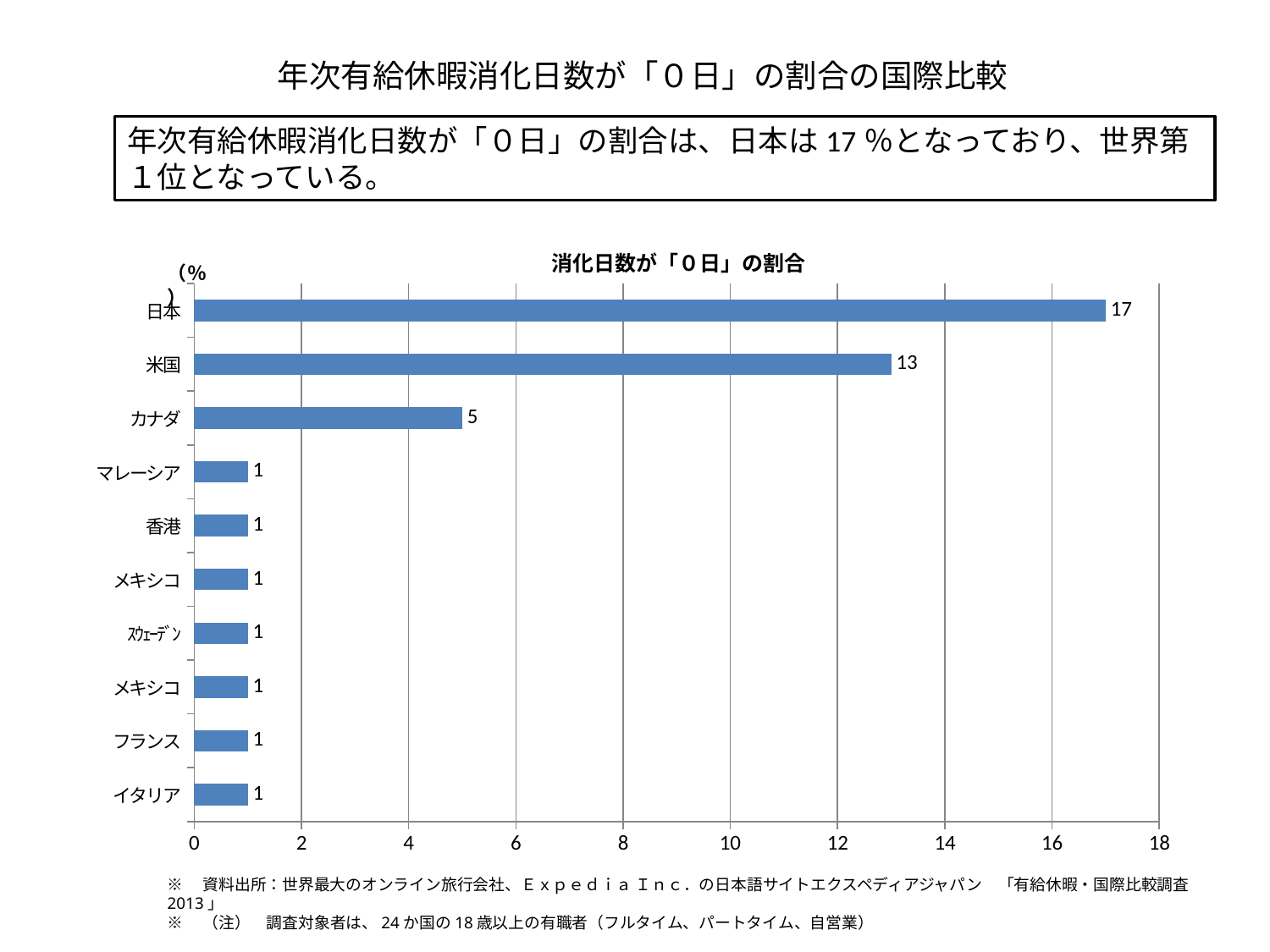
What is the difference between the values for 米国 and カナダ? 8 How many bars (categories) are shown in the chart? 10 What is the title of the chart? 消化日数が「０日」の割合 What is the value for 日本 in the chart? 17 Is the value for 日本 greater or less than 16? greater Which is larger, the value for カナダ or the value for 香港? カナダ What is the value for 米国 in the chart? 13 What is the value for フランス in the chart? 1 Which country has the highest value in the chart? 日本 What is the value for カナダ in the chart? 5 What kind of chart is shown on the slide? Bar chart What is the difference between the values for 日本 and 米国? 4